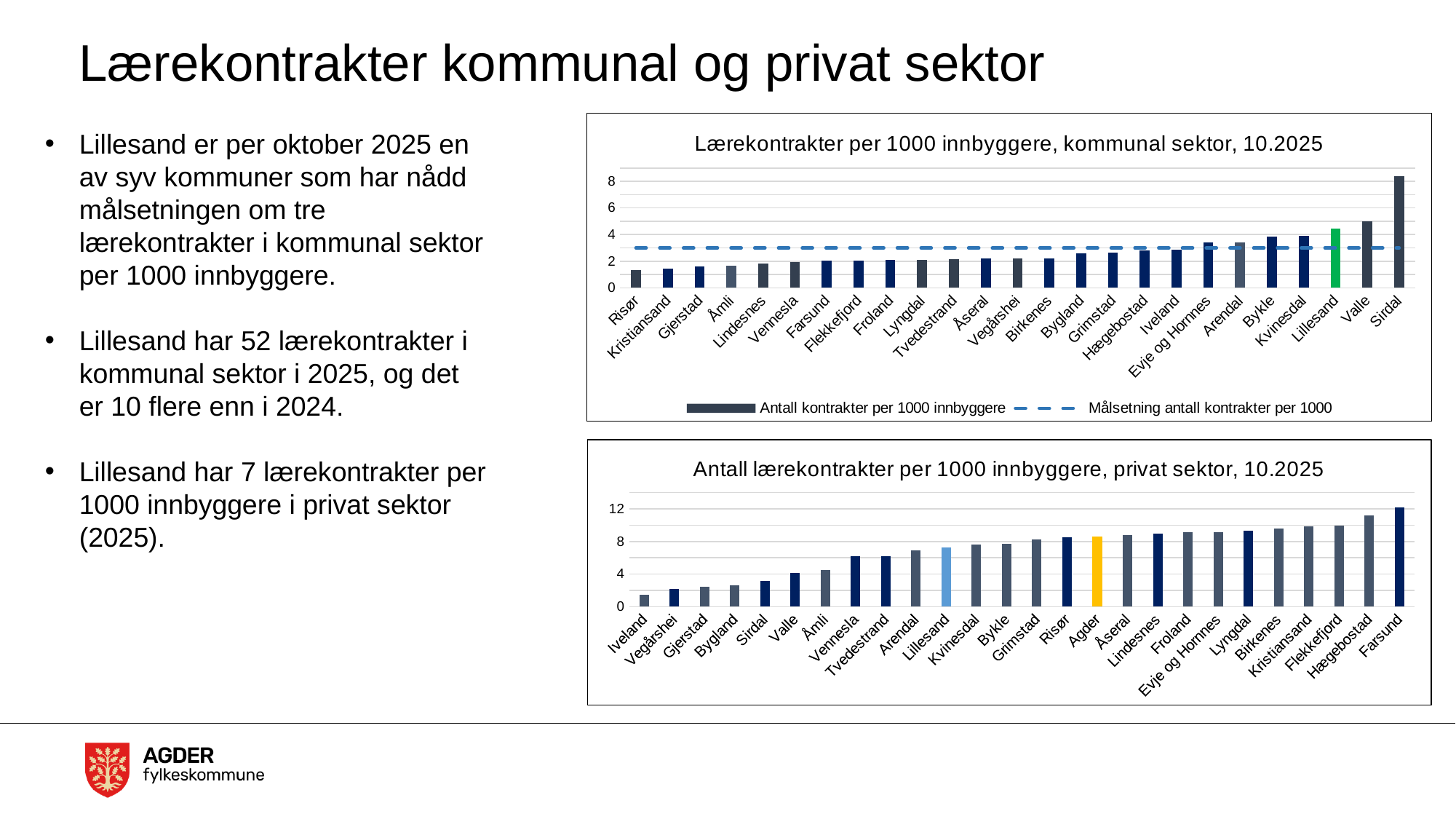
In the top chart (kommunal sektor), do the bar values rise or fall from left to right along the x axis? rise In the top chart (kommunal sektor), which municipality has the lowest value? Risør What type of chart is the top chart, 'Lærekontrakter per 1000 innbyggere, kommunal sektor, 10.2025'? combination bar and line chart In the top chart (kommunal sektor), how many entries does the legend list? 2 In the bottom chart (privat sektor), which municipality has the lowest value? Iveland In the bottom chart (privat sektor), is the value for Lillesand greater or less than 4? greater In the bottom chart (privat sektor), which municipality has the highest value? Farsund In the top chart (kommunal sektor), is the value for Risør greater or less than 2? less In the top chart (kommunal sektor), is the value for Sirdal greater or less than 6? greater In the bottom chart (privat sektor), how many municipalities/categories are shown on the x axis? 26 In the top chart (kommunal sektor), which municipality has the highest value? Sirdal In the bottom chart (privat sektor), which is larger, the value for Farsund or the value for Iveland? Farsund